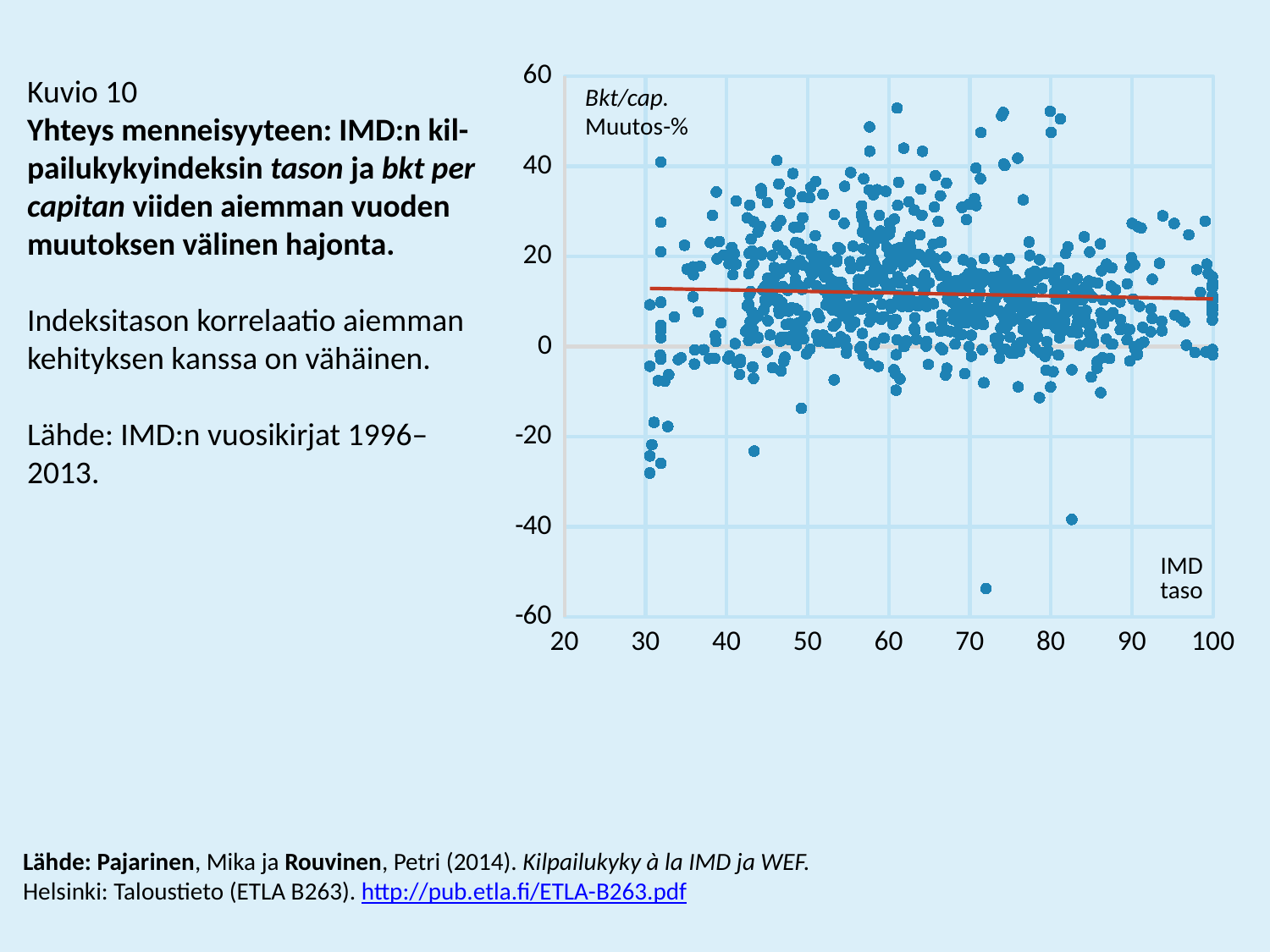
What is the label on the horizontal axis of the chart? IMD taso What is the minimum value shown on the horizontal axis of the chart? 20 Is the highest plotted point on the chart greater or less than 40 on the vertical axis? greater Is the lowest plotted point located at an IMD taso greater or less than 60? greater What kind of chart is shown on the slide? scatter plot Is the value of the trend line at IMD taso 100 greater or less than 0? greater What is the label on the vertical axis of the chart? Bkt/cap. Muutos-% Does the fitted trend line rise or fall as the IMD taso increases along the x axis? falls slightly